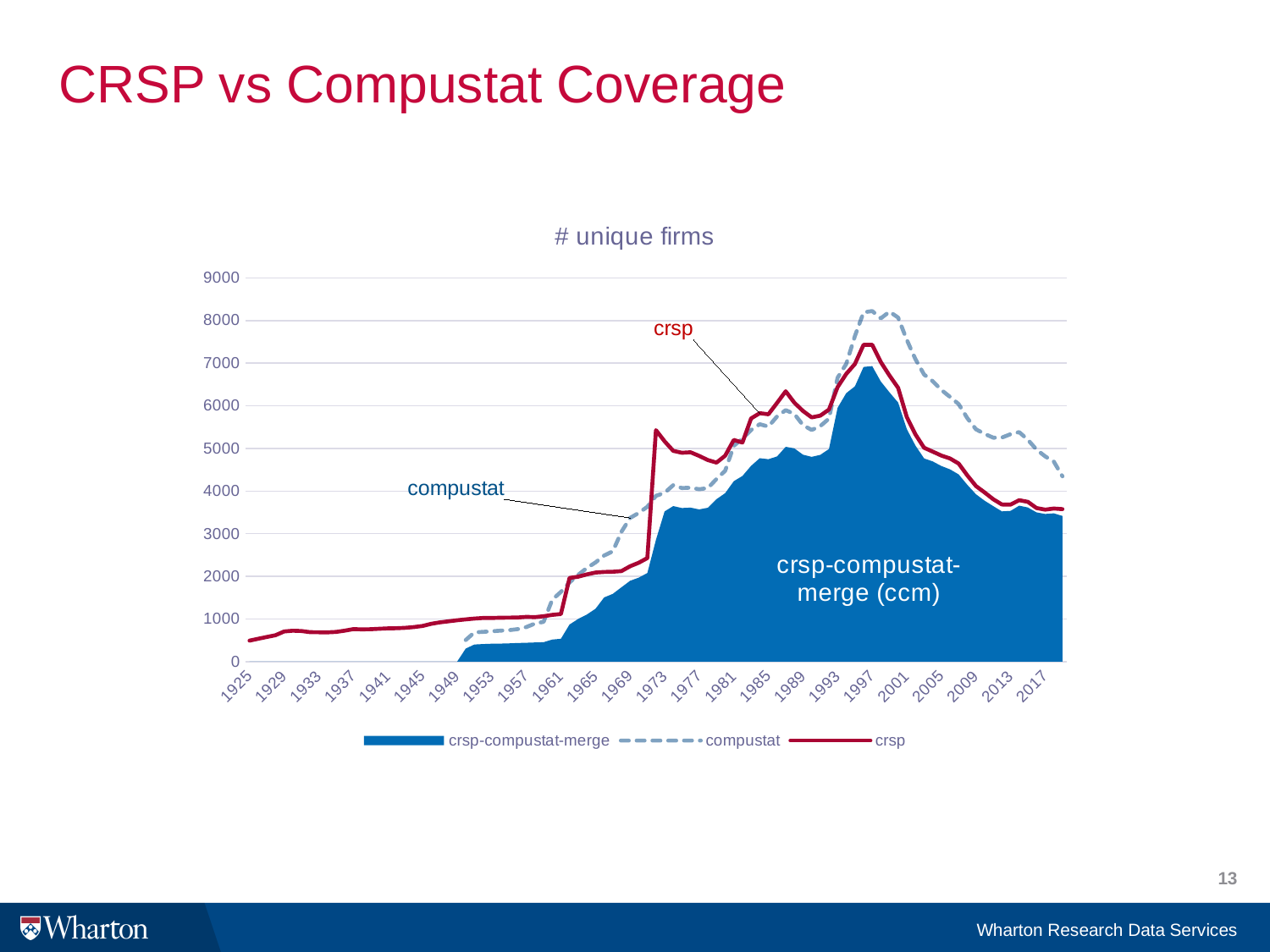
Is the peak value of crsp greater or less than 7000? greater Is the value for crsp in 1925 greater or less than 1000? less How many series does the legend list? 3 Which series is drawn as a dashed line? compustat Is the value for crsp-compustat-merge in 2017 greater or less than 4000? less In 2017, which is larger, compustat or crsp? compustat What is the title of the chart? # unique firms In 1973, which is larger, crsp or compustat? crsp Which series reaches the highest peak on the chart? compustat Does the crsp series rise or fall from 1997 to 2017? fall Which series has the lowest values across the whole chart? crsp-compustat-merge